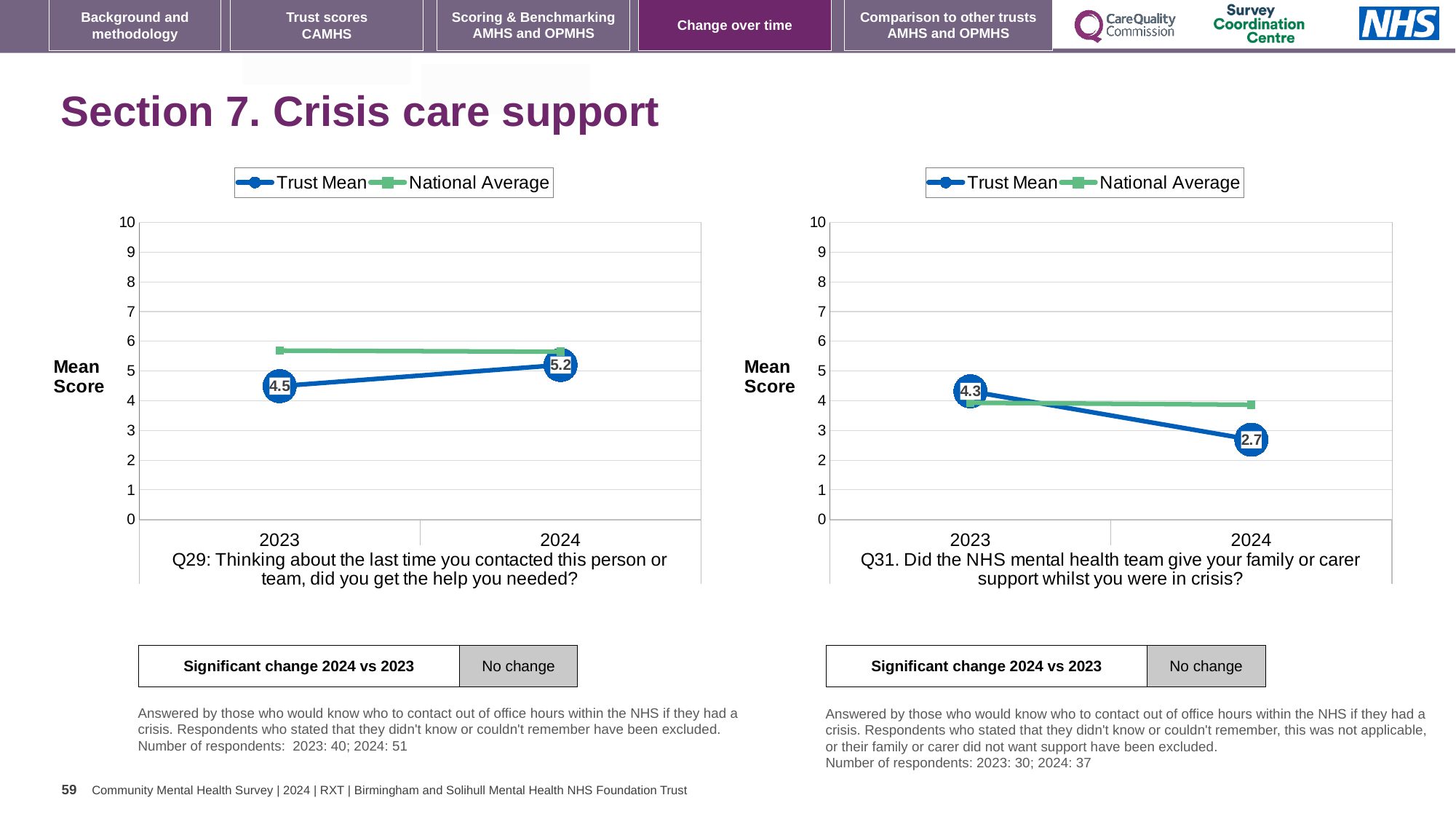
In the Q31 chart on the right, does the Trust Mean rise or fall from 2023 to 2024? fall In the Q31 chart on the right, what is the Trust Mean for 2024? 2.7 In the Q31 chart on the right, is the National Average for 2024 greater or less than 3? greater In the Q29 chart on the left, what is the Trust Mean for 2024? 5.2 In the Q29 chart on the left, what is the Trust Mean for 2023? 4.5 In the Q31 chart on the right, what is the difference between the Trust Mean for 2023 and 2024? 1.6 In the Q29 chart on the left, which is higher in 2023, the Trust Mean or the National Average? National Average In the Q31 chart on the right, what is the Trust Mean for 2023? 4.3 What kind of chart is the Q31 chart on the right? line chart In the Q29 chart on the left, by how much did the Trust Mean change from 2023 to 2024? 0.7 How many series does the legend of the Q29 chart on the left list? 2 In the Q29 chart on the left, does the Trust Mean rise or fall from 2023 to 2024? rise